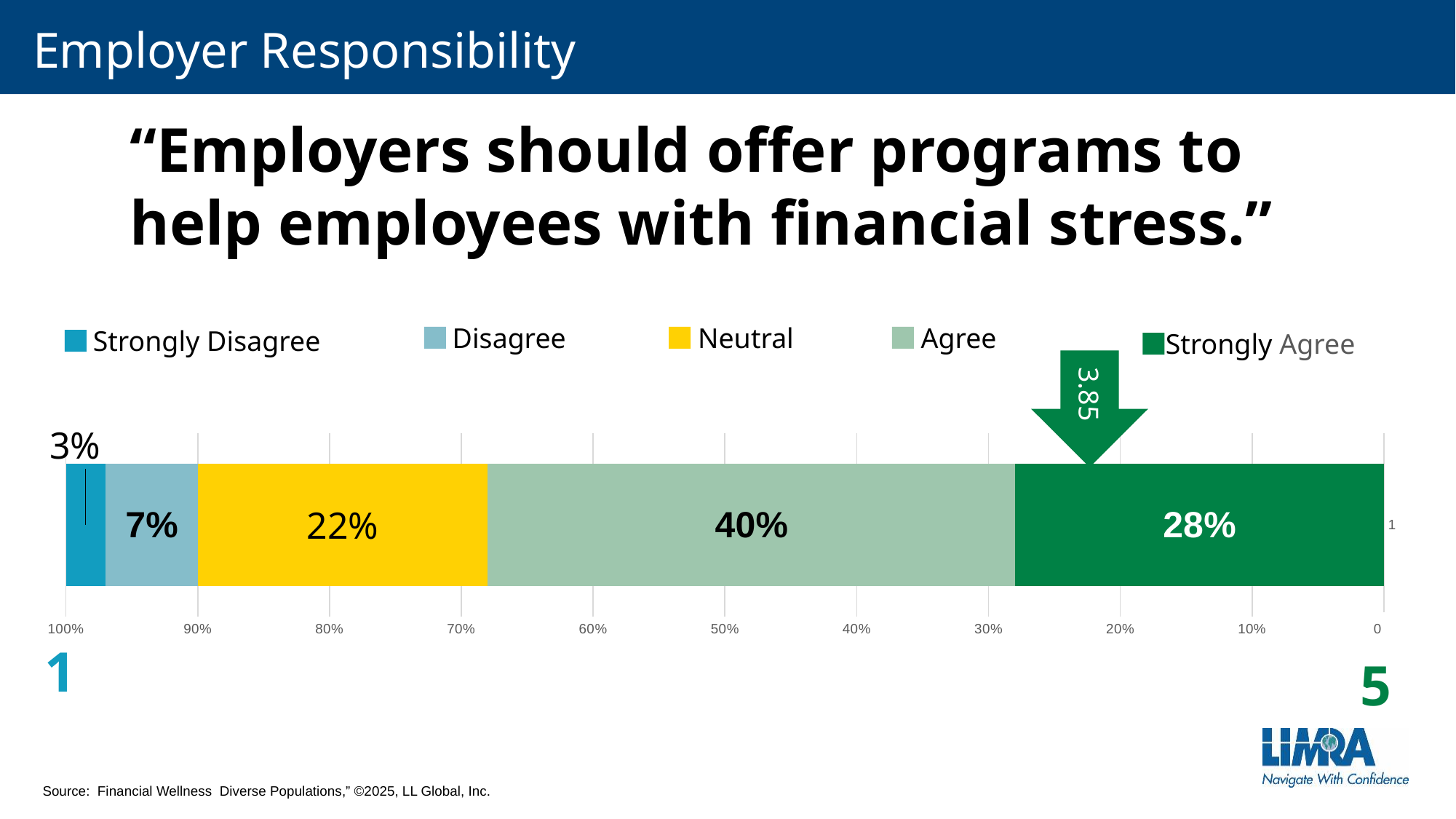
What percentage of respondents answered Strongly Agree? 28% What percentage of respondents answered Strongly Disagree? 3% Which is larger, the Neutral share or the Disagree share? Neutral What percentage of respondents answered Neutral? 22% What mean score is shown by the arrow above the bar? 3.85 What percentage of respondents answered Disagree? 7% Which response category has the largest share? Agree What percentage of respondents answered Agree? 40% What is the difference between the Agree and Strongly Agree percentages? 12% Which response category has the smallest share? Strongly Disagree How many response categories does the legend list? 5 What kind of chart is shown on the slide? Stacked bar chart